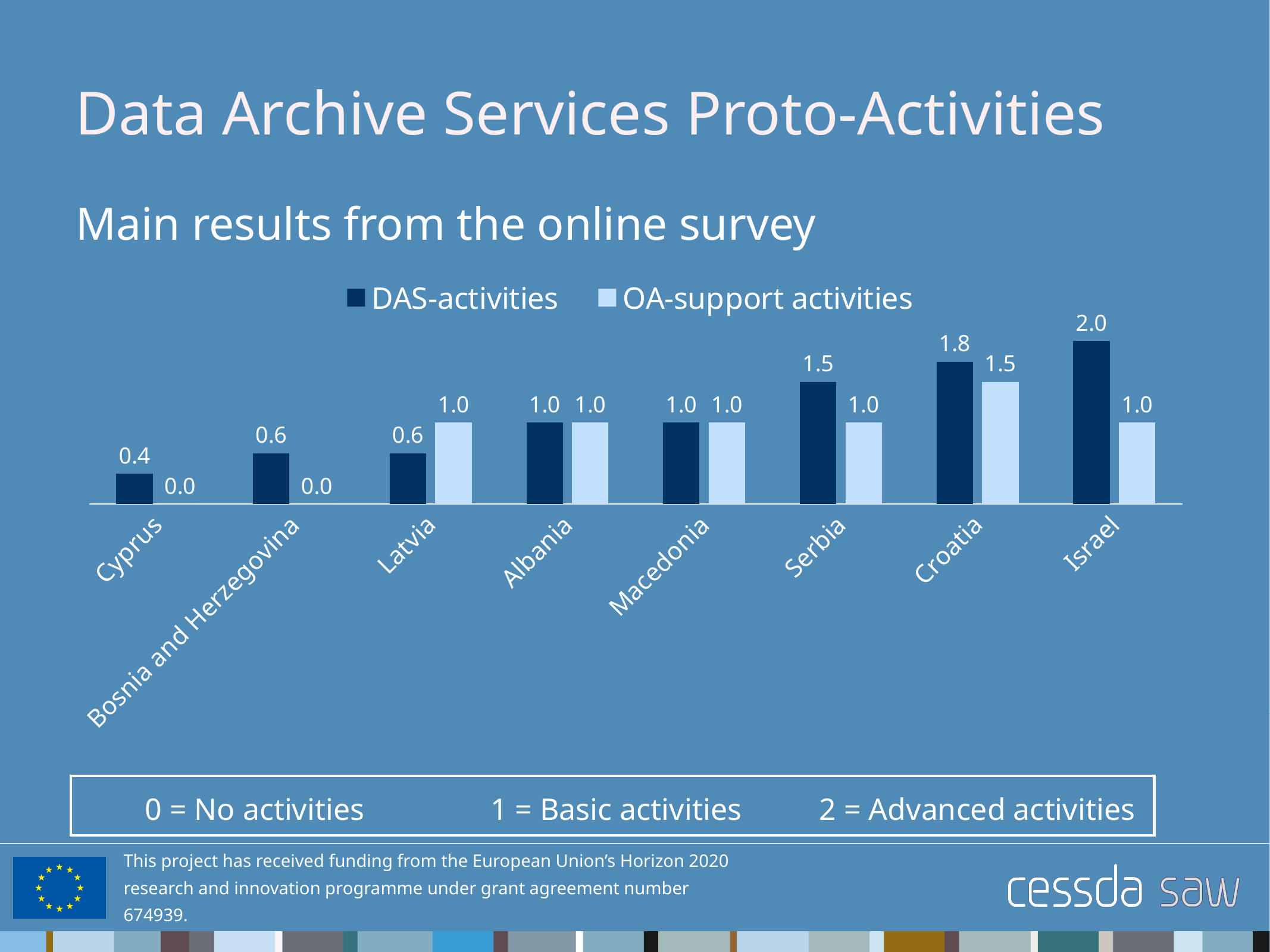
Which country has the highest OA-support activities value? Croatia Do the DAS-activities values rise or fall from Cyprus to Israel along the x axis? Rise What is the OA-support activities value for Serbia? 1.0 Which is larger for Latvia: the DAS-activities value or the OA-support activities value? OA-support activities What kind of chart is shown on the slide? Bar chart What is the difference between the DAS-activities value for Israel and the DAS-activities value for Croatia? 0.2 Which country has the highest DAS-activities value? Israel Which country has the lowest DAS-activities value? Cyprus How many countries are shown on the x axis? 8 What is the DAS-activities value for Cyprus? 0.4 What is the DAS-activities value for Croatia? 1.8 How many series does the legend list? 2